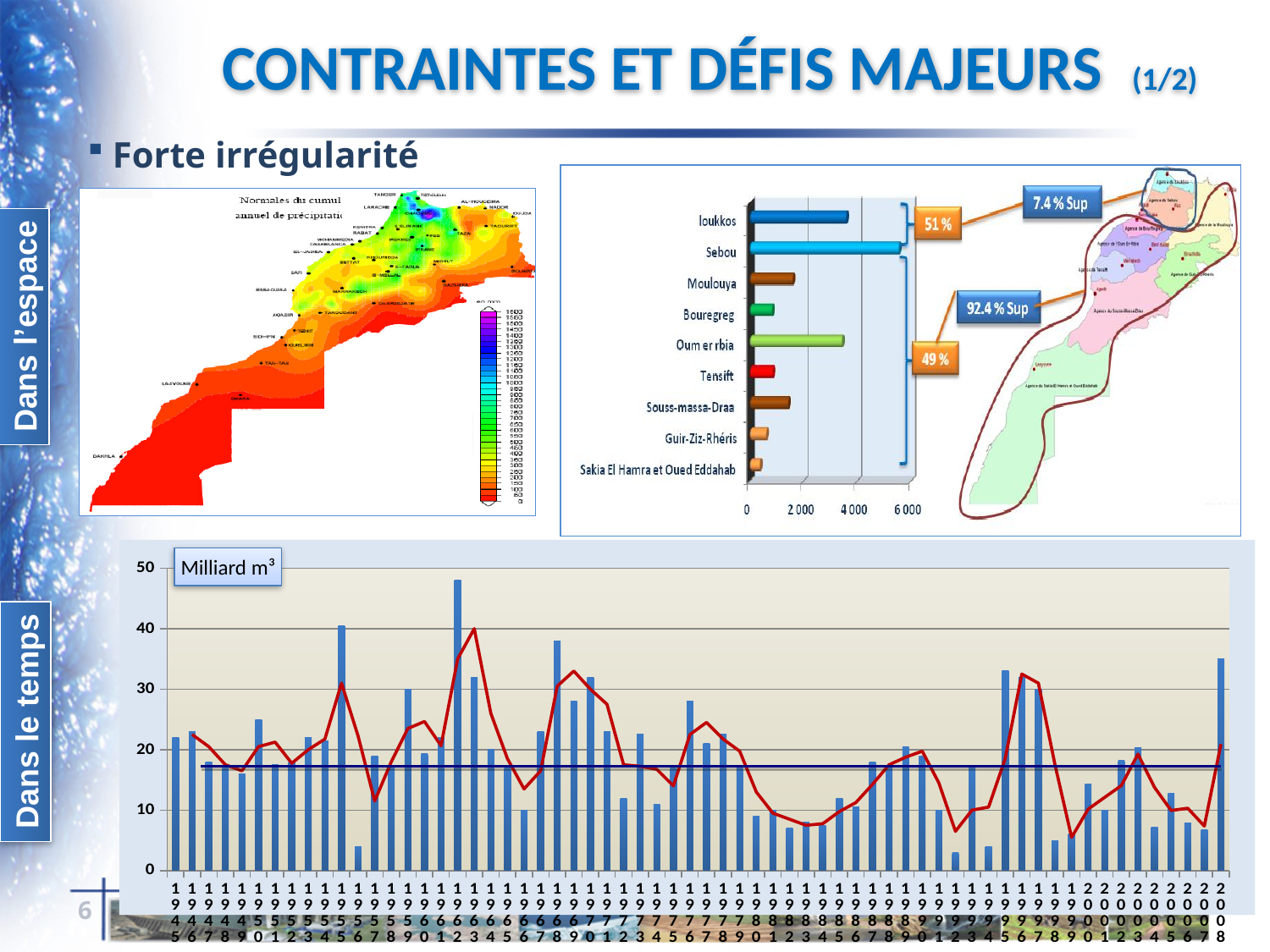
In the top-right bar chart of river basins, which basin has the highest value? Sebou In the top-right bar chart of river basins, how many basins (categories) are listed? 9 In the top-right bar chart of river basins, which has the larger value, Sebou or Moulouya? Sebou In the top-right bar chart of river basins, is the value for Oum er rbia greater or less than 2 000? greater In the bottom chart of the slide, is the bar for 2008 greater or less than 30? greater In the top-right bar chart of river basins, which has the larger value, Loukkos or Bouregreg? Loukkos In the top-right bar chart of river basins, is the value for Sebou greater or less than 4 000? greater In the top-right bar chart of river basins, what percentage label is shown next to the bracket grouping Loukkos and Sebou? 51 % What unit is shown in the label box of the bottom chart of the slide? Milliard m³ What kind of chart is the chart in the top right of the slide showing river basins such as Sebou and Loukkos? bar chart